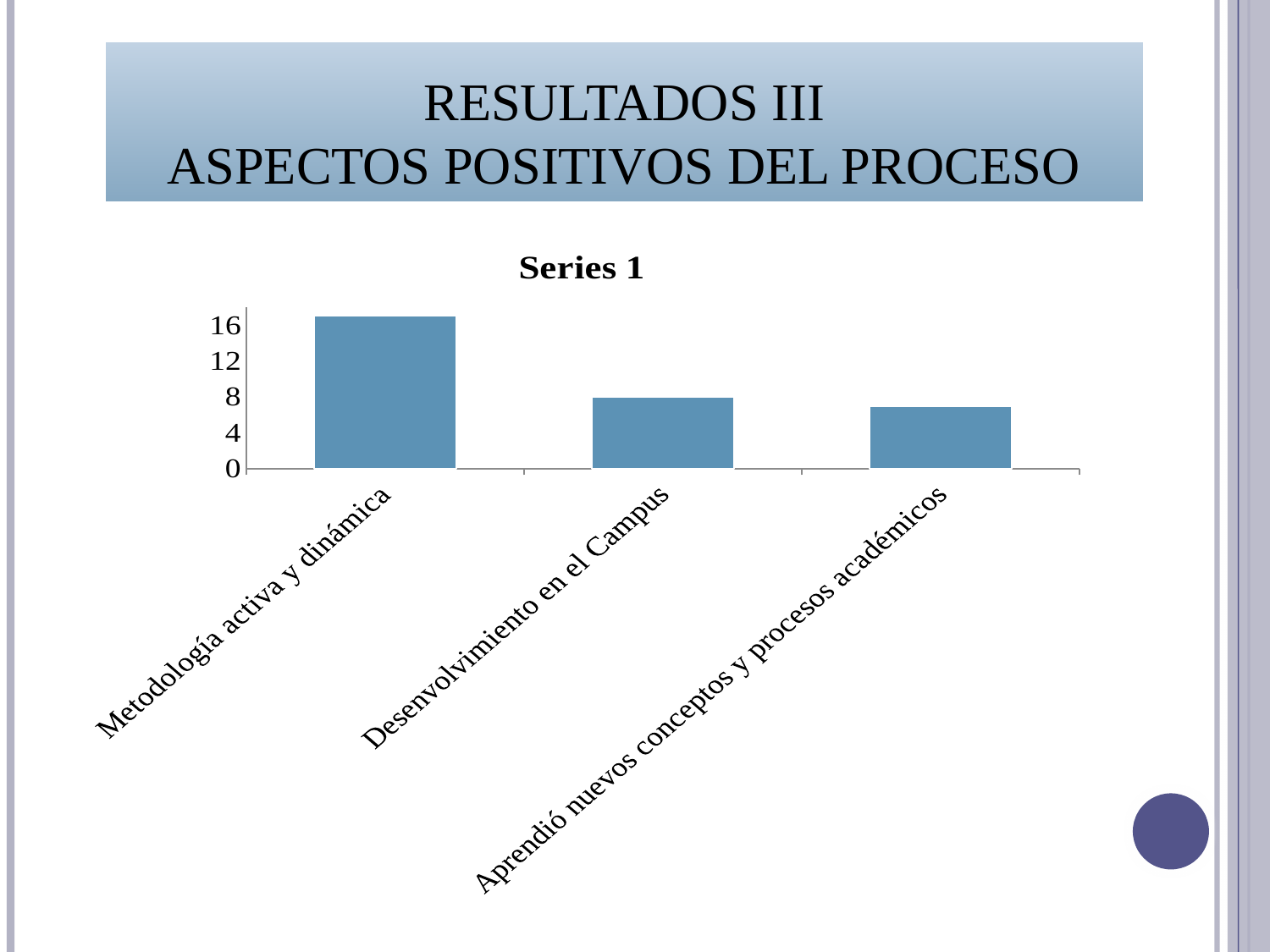
What is the highest value shown on the vertical axis? 16 Is the value for Metodología activa y dinámica greater or less than 16? greater Which category has the highest value? Metodología activa y dinámica What kind of chart is shown on the slide? bar chart Which category has the lowest value? Aprendió nuevos conceptos y procesos académicos Is the value for Metodología activa y dinámica greater or less than 12? greater Which is larger, the value for Desenvolvimiento en el Campus or the value for Aprendió nuevos conceptos y procesos académicos? Desenvolvimiento en el Campus What is the value for Desenvolvimiento en el Campus? 8 Do the values rise or fall from left to right along the x axis? fall What is the title of the chart? Series 1 Is the value for Aprendió nuevos conceptos y procesos académicos greater or less than 8? less How many categories are plotted in the chart? 3